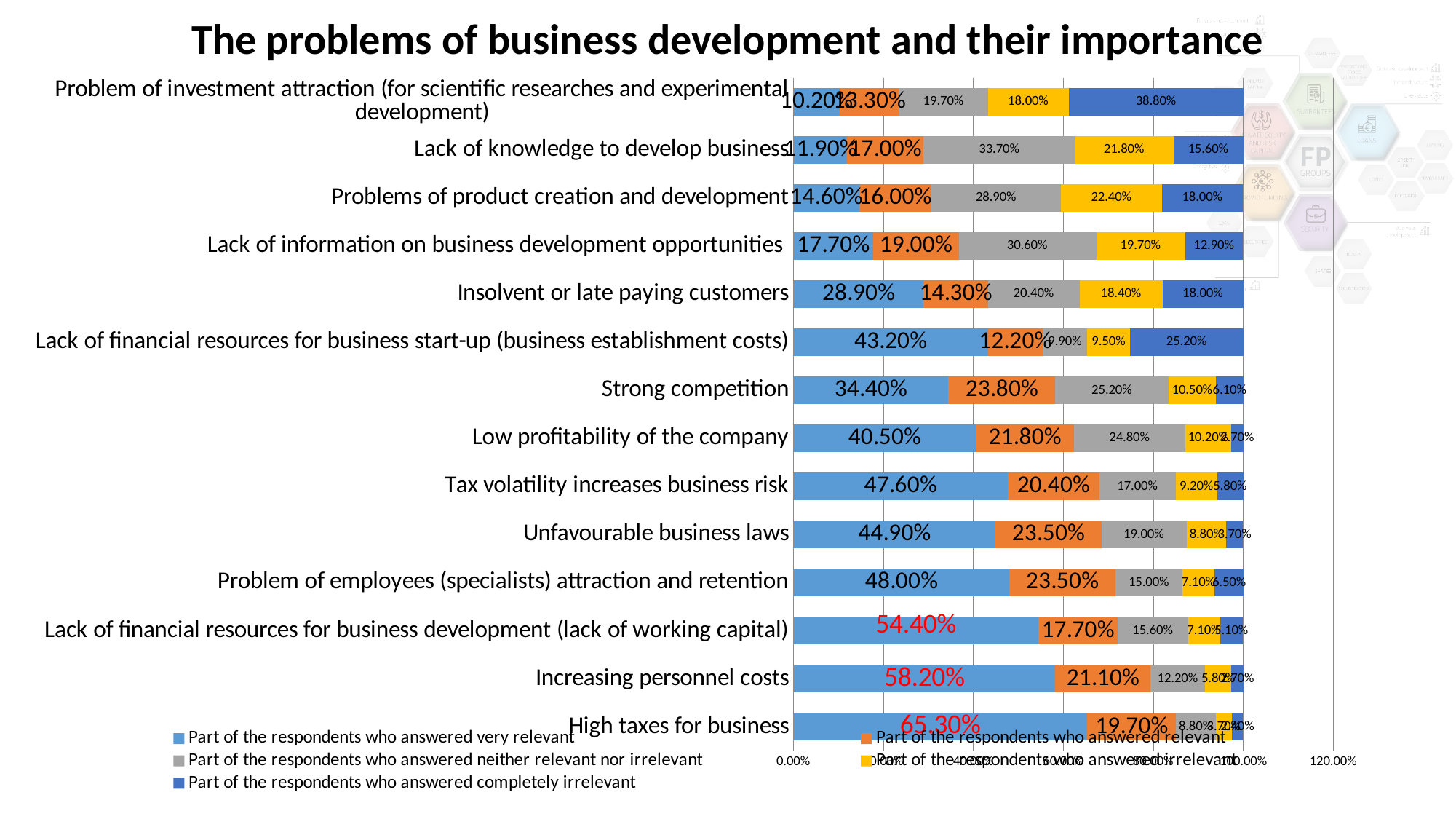
What share of respondents answered 'neither relevant nor irrelevant' for 'Lack of knowledge to develop business'? 33.70% Which has a larger 'relevant' share: 'Strong competition' or 'Insolvent or late paying customers'? Strong competition Which problem has the highest share of respondents answering 'very relevant'? High taxes for business What is the difference between the 'very relevant' shares for 'Increasing personnel costs' and 'Lack of financial resources for business development (lack of working capital)'? 3.80% What share of respondents answered 'completely irrelevant' for 'Problem of investment attraction (for scientific researches and experimental development)'? 38.80% How many problem categories are listed on the chart? 14 Which problem has the lowest share of respondents answering 'very relevant'? Problem of investment attraction (for scientific researches and experimental development) What type of chart is shown on the slide? Stacked bar chart What share of respondents answered 'very relevant' for 'High taxes for business'? 65.30% What share of respondents answered 'very relevant' for 'Increasing personnel costs'? 58.20% How many series does the legend list? 5 What is the title of the chart? The problems of business development and their importance